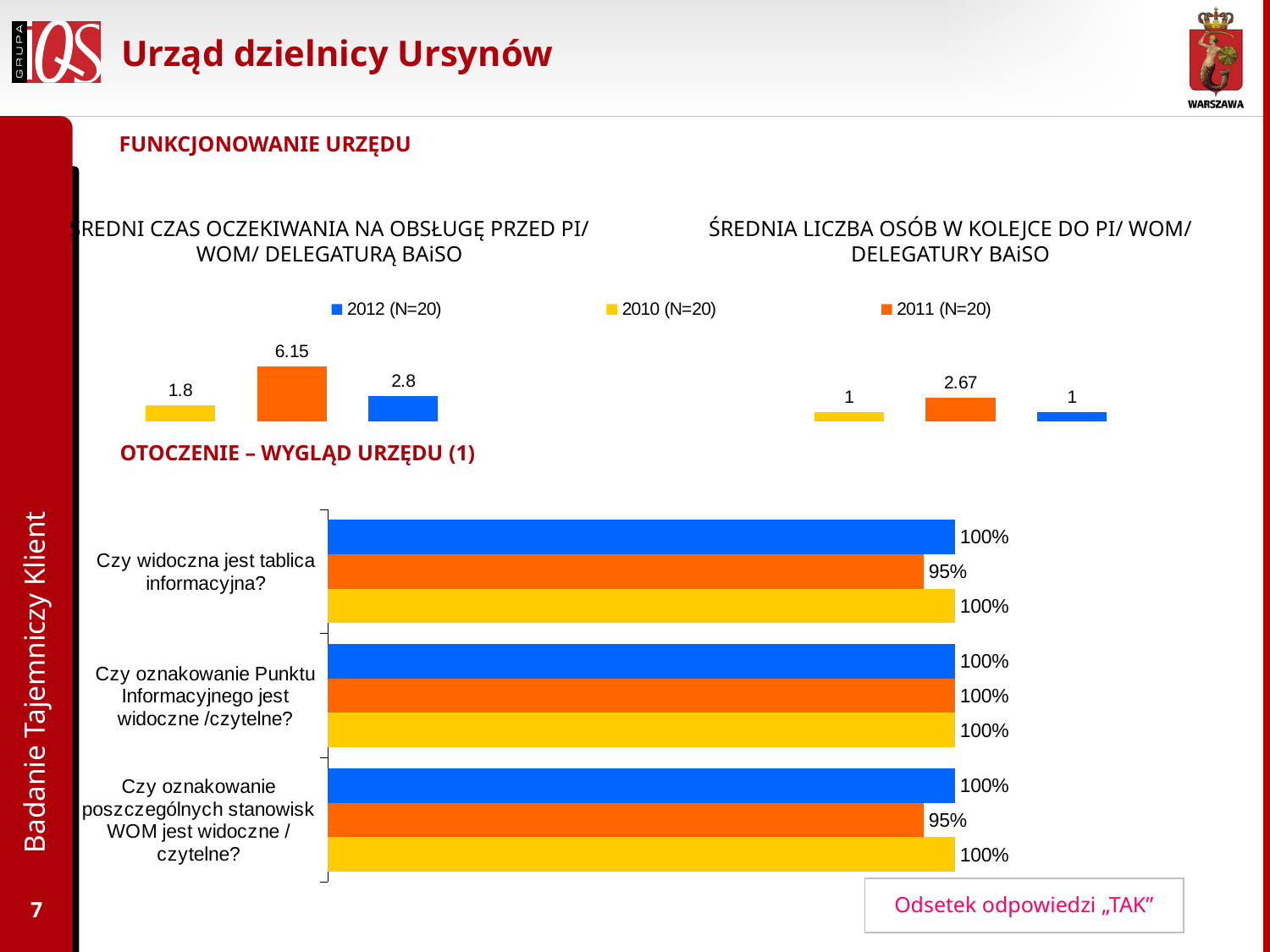
In the chart 'ŚREDNIA LICZBA OSÓB W KOLEJCE DO PI/ WOM/ DELEGATURY BAiSO', is the value for 2010 or 2011 larger? 2011 How many series does the legend on the slide list? 3 In the bottom chart 'OTOCZENIE – WYGLĄD URZĘDU (1)', what is the 2011 value for 'Czy widoczna jest tablica informacyjna?'? 95% In the chart 'ŚREDNI CZAS OCZEKIWANIA NA OBSŁUGĘ PRZED PI/ WOM/ DELEGATURĄ BAiSO', what is the difference between the 2011 and 2012 values? 3.35 In the chart 'ŚREDNI CZAS OCZEKIWANIA NA OBSŁUGĘ PRZED PI/ WOM/ DELEGATURĄ BAiSO', what is the value for 2010 (N=20)? 1.8 In the chart 'ŚREDNI CZAS OCZEKIWANIA NA OBSŁUGĘ PRZED PI/ WOM/ DELEGATURĄ BAiSO', what is the value for 2011 (N=20)? 6.15 In the bottom chart 'OTOCZENIE – WYGLĄD URZĘDU (1)', what is the 2011 value for 'Czy oznakowanie Punktu Informacyjnego jest widoczne /czytelne?'? 100% In the chart 'ŚREDNIA LICZBA OSÓB W KOLEJCE DO PI/ WOM/ DELEGATURY BAiSO', what is the value for 2012 (N=20)? 1 In the chart 'ŚREDNI CZAS OCZEKIWANIA NA OBSŁUGĘ PRZED PI/ WOM/ DELEGATURĄ BAiSO', which year has the highest value? 2011 (N=20) What type of chart is the bottom chart 'OTOCZENIE – WYGLĄD URZĘDU (1)'? Bar chart In the chart 'ŚREDNIA LICZBA OSÓB W KOLEJCE DO PI/ WOM/ DELEGATURY BAiSO', what is the value for 2011 (N=20)? 2.67 In the bottom chart 'OTOCZENIE – WYGLĄD URZĘDU (1)', how many question categories are shown? 3